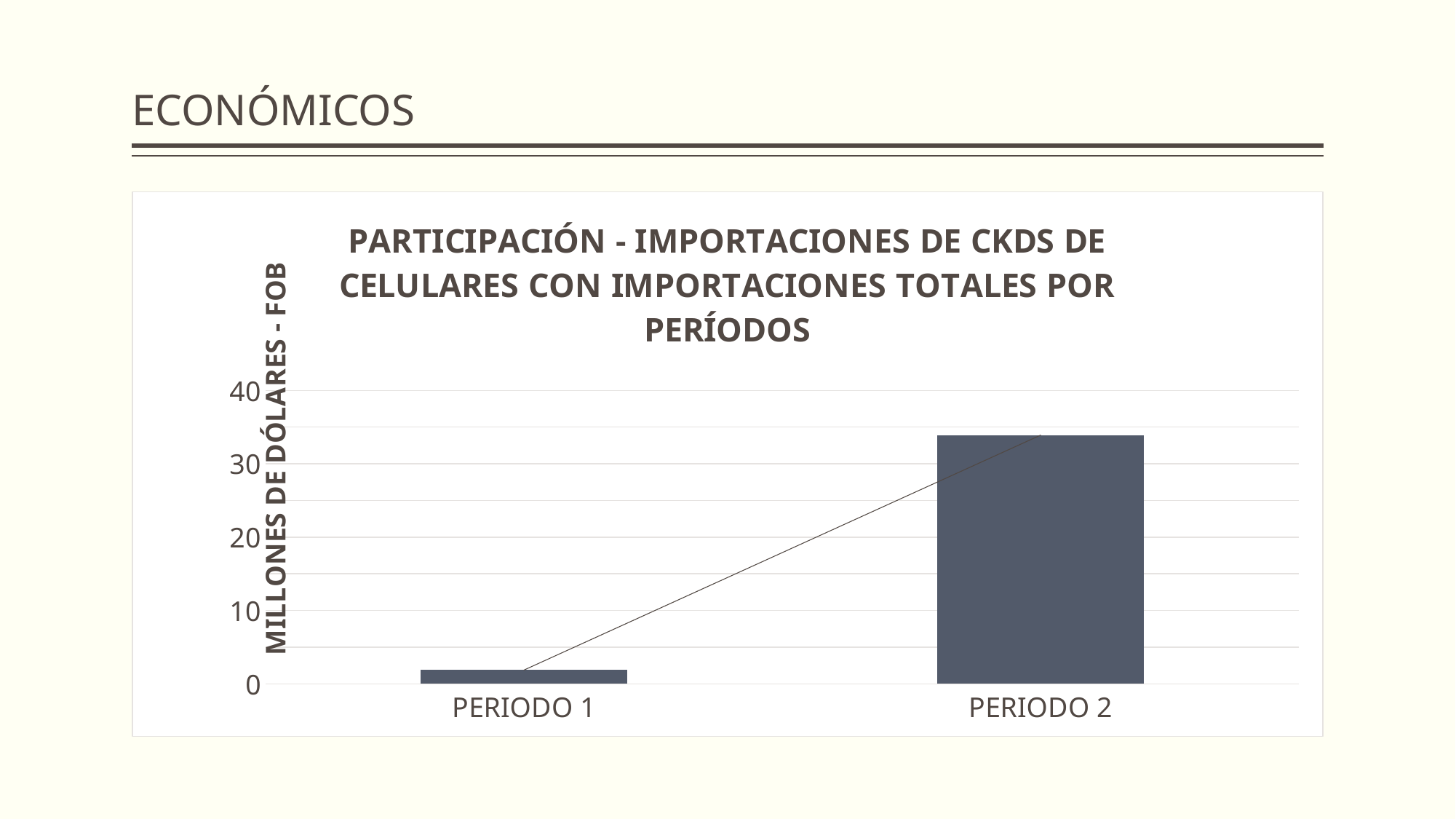
Is the value for PERIODO 2 greater or less than 30? greater What is the label of the vertical axis of the chart? MILLONES DE DÓLARES - FOB How many categories are shown on the x axis of the chart? 2 Which period has the lowest value in the chart? PERIODO 1 Is the value for PERIODO 2 greater or less than 40? less What kind of chart is shown on the slide? bar chart Is the value for PERIODO 1 greater or less than 10? less Which period has the highest value in the chart? PERIODO 2 Which is larger, the value for PERIODO 1 or PERIODO 2? PERIODO 2 Do the values rise or fall from PERIODO 1 to PERIODO 2? rise What is the title of the chart? PARTICIPACIÓN - IMPORTACIONES DE CKDS DE CELULARES CON IMPORTACIONES TOTALES POR PERÍODOS